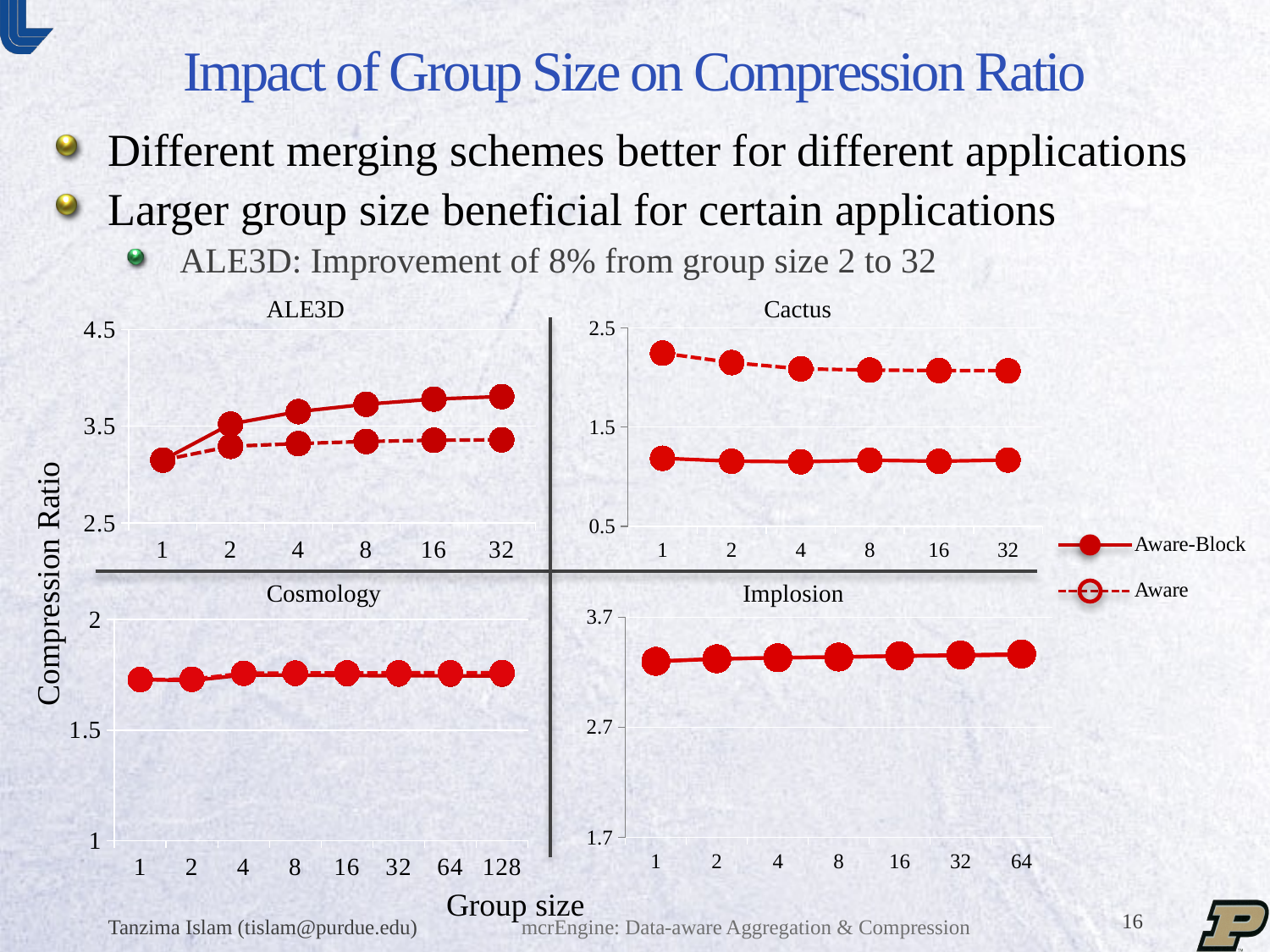
In the Cactus chart, at group size 1, which series has the larger compression ratio, Aware or Aware-Block? Aware How many series does the legend list? 2 Which series is drawn with a dashed line in the legend? Aware In the Cactus chart, is the Aware value at group size 1 greater or less than 1.5? greater In the Cosmology chart, how many group sizes are plotted on the x axis? 8 In the ALE3D chart, how many group sizes are plotted on the x axis? 6 In the Cactus chart, is the Aware-Block value at group size 1 greater or less than 1.5? less In the ALE3D chart, does the Aware-Block series rise or fall as group size increases? rise In the ALE3D chart, is the Aware-Block value at group size 32 greater or less than 3.5? greater What kind of chart is the ALE3D chart? line chart In the Implosion chart, how many group sizes are plotted on the x axis? 7